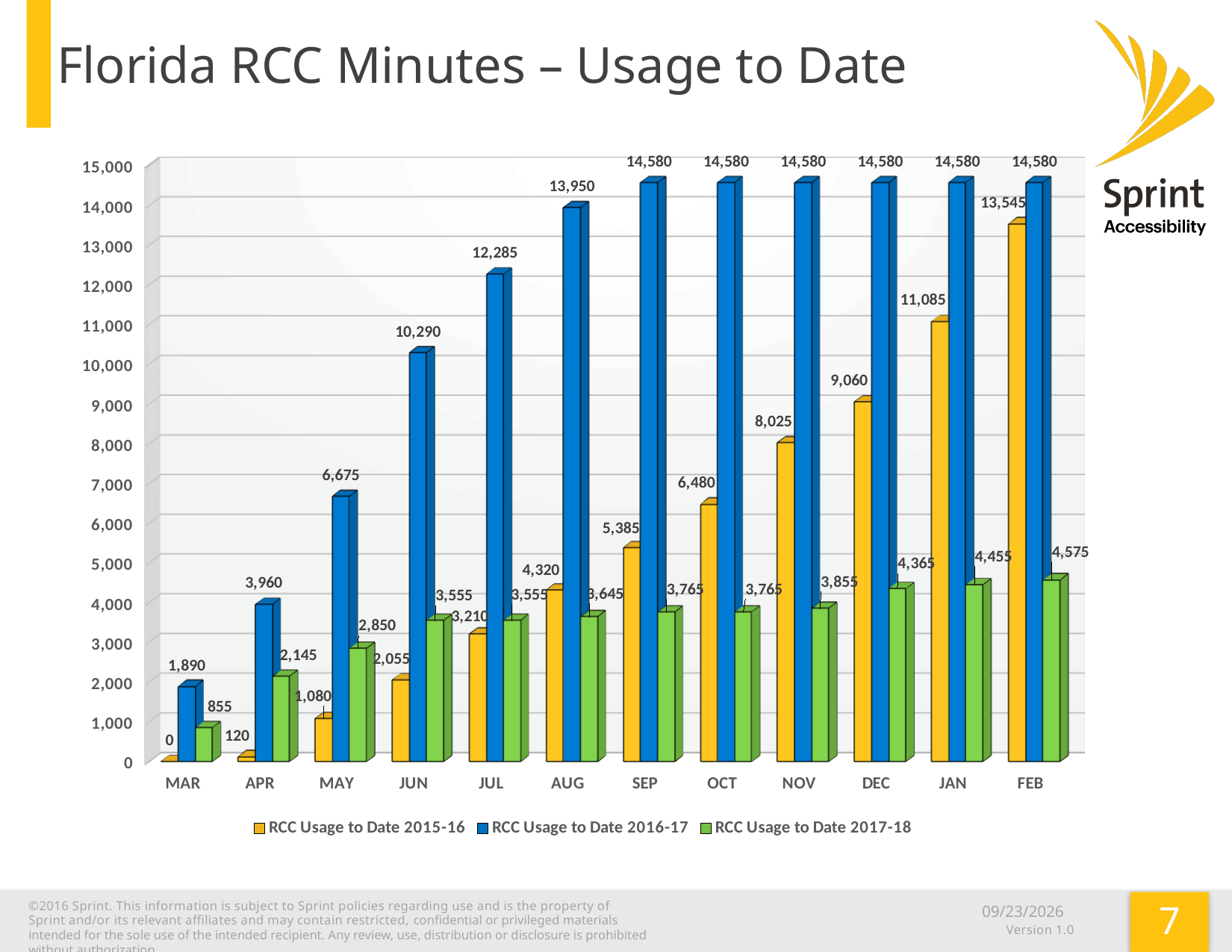
What is the difference between the RCC Usage to Date 2016-17 and 2015-16 values for MAY? 5,595 What colour are the RCC Usage to Date 2016-17 bars? Blue Which month has the highest RCC Usage to Date 2017-18 value? FEB What is the RCC Usage to Date 2017-18 value for DEC? 4,365 Which is larger in AUG: RCC Usage to Date 2015-16 or RCC Usage to Date 2017-18? RCC Usage to Date 2015-16 What kind of chart is shown on the slide? Bar chart Which month has the lowest RCC Usage to Date 2015-16 value? MAR Do the RCC Usage to Date 2015-16 values rise or fall from MAR to FEB? Rise How many months are shown on the x axis? 12 What is the RCC Usage to Date 2016-17 value for JUN? 10,290 How many series does the legend list? 3 What is the RCC Usage to Date 2015-16 value for FEB? 13,545